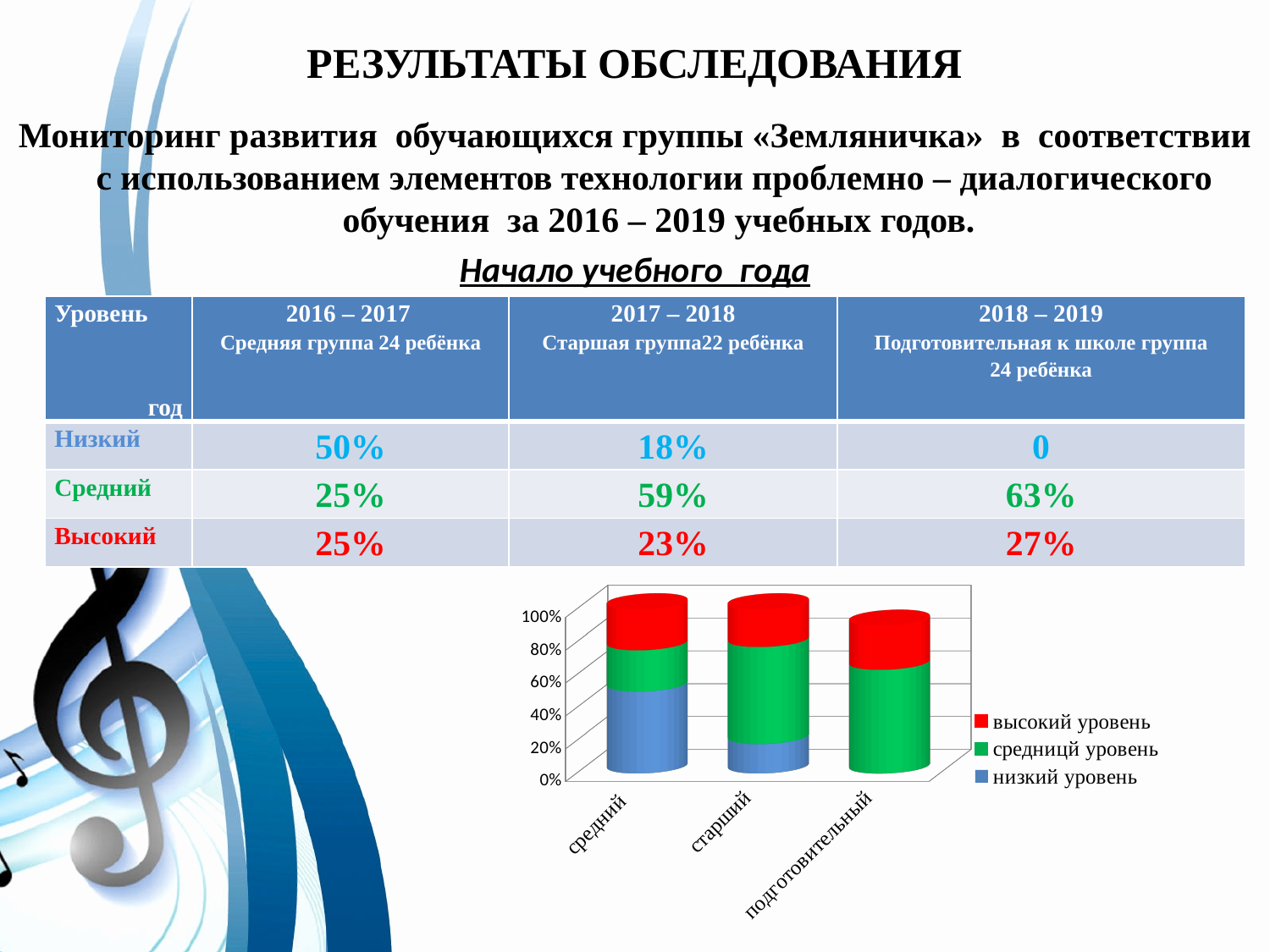
In the chart, which category has the largest низкий уровень segment? средний How many series does the chart legend list? 3 In the chart, is the низкий уровень segment for старший greater or less than 40%? less In the chart, is the высокий уровень segment for средний greater or less than 40%? less In the chart, which category has the smallest низкий уровень segment? подготовительный What kind of chart is shown at the bottom of the slide? Stacked bar chart In the chart, is the низкий уровень segment for средний greater or less than 40%? greater What are the three entries in the chart legend? высокий уровень, средниций уровень, низкий уровень Does the низкий уровень segment rise or fall from средний to подготовительный along the x axis? Falls How many categories are shown on the x axis of the chart? 3 What colour represents низкий уровень in the chart? Blue In the chart, which has the larger низкий уровень segment, средний or старший? средний